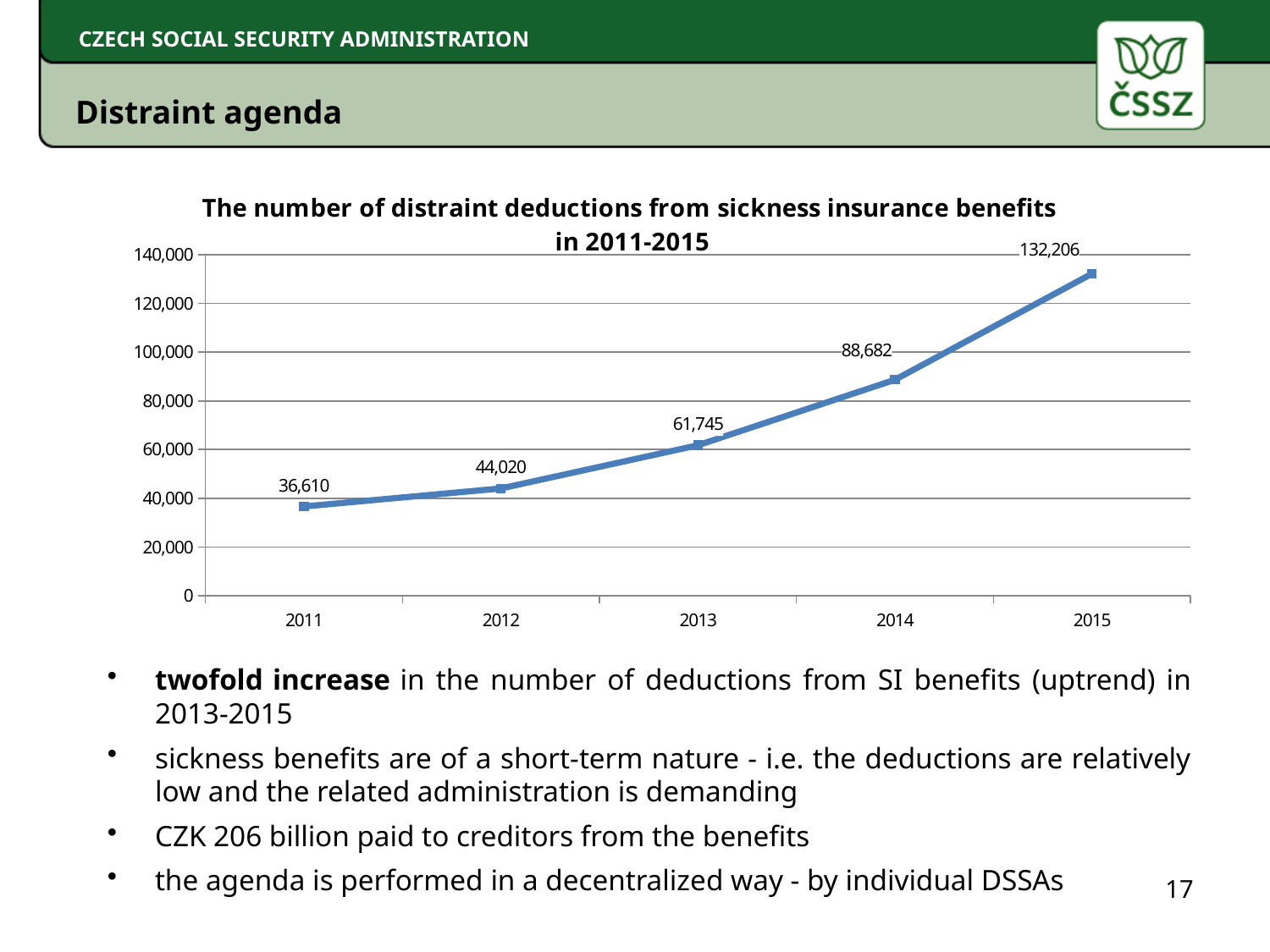
Which year has the highest number of distraint deductions? 2015 What is the difference between the number of deductions in 2015 and in 2014? 43,524 Which year has the lowest number of distraint deductions? 2011 What is the difference between the number of deductions in 2012 and in 2011? 7,410 Do the values rise or fall from 2011 to 2015? rise Which year has more distraint deductions, 2013 or 2014? 2014 What kind of chart is shown on the slide? line chart Is the value for 2014 greater or less than 80,000? greater What is the number of distraint deductions from sickness insurance benefits in 2013? 61,745 What is the number of distraint deductions from sickness insurance benefits in 2015? 132,206 What is the number of distraint deductions from sickness insurance benefits in 2011? 36,610 How many years are plotted on the chart? 5